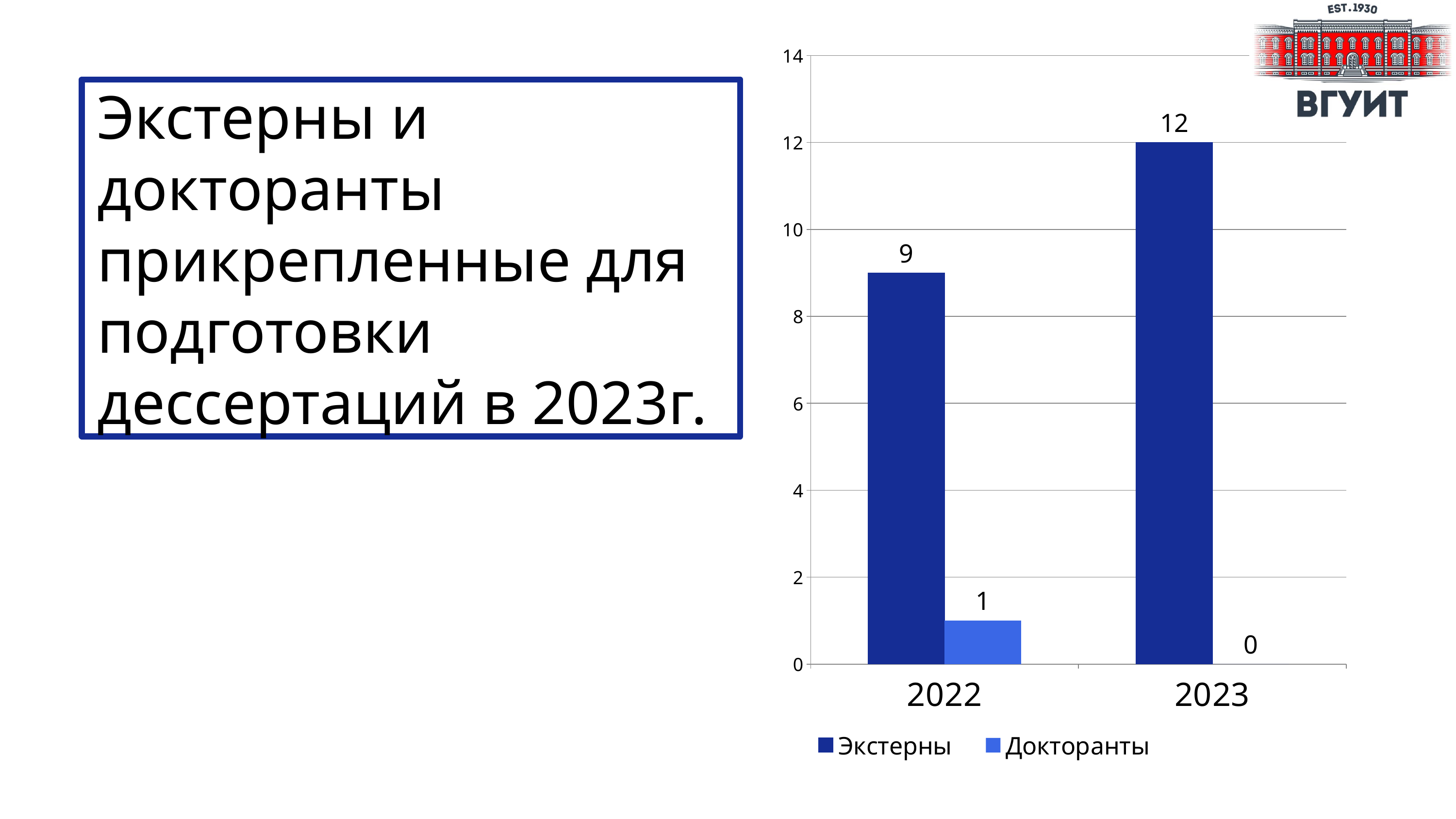
In which year is the value for Экстерны highest? 2023 What is the value for Экстерны in 2023? 12 Which is larger in 2022: Экстерны or Докторанты? Экстерны What is the value for Докторанты in 2023? 0 What is the value for Докторанты in 2022? 1 How many years are shown on the x axis? 2 What kind of chart is shown on the slide? bar chart Is the value for Экстерны in 2023 greater or less than 10? greater In which year is the value for Докторанты lowest? 2023 What is the difference between the Экстерны values for 2023 and 2022? 3 How many series does the legend list? 2 What is the value for Экстерны in 2022? 9